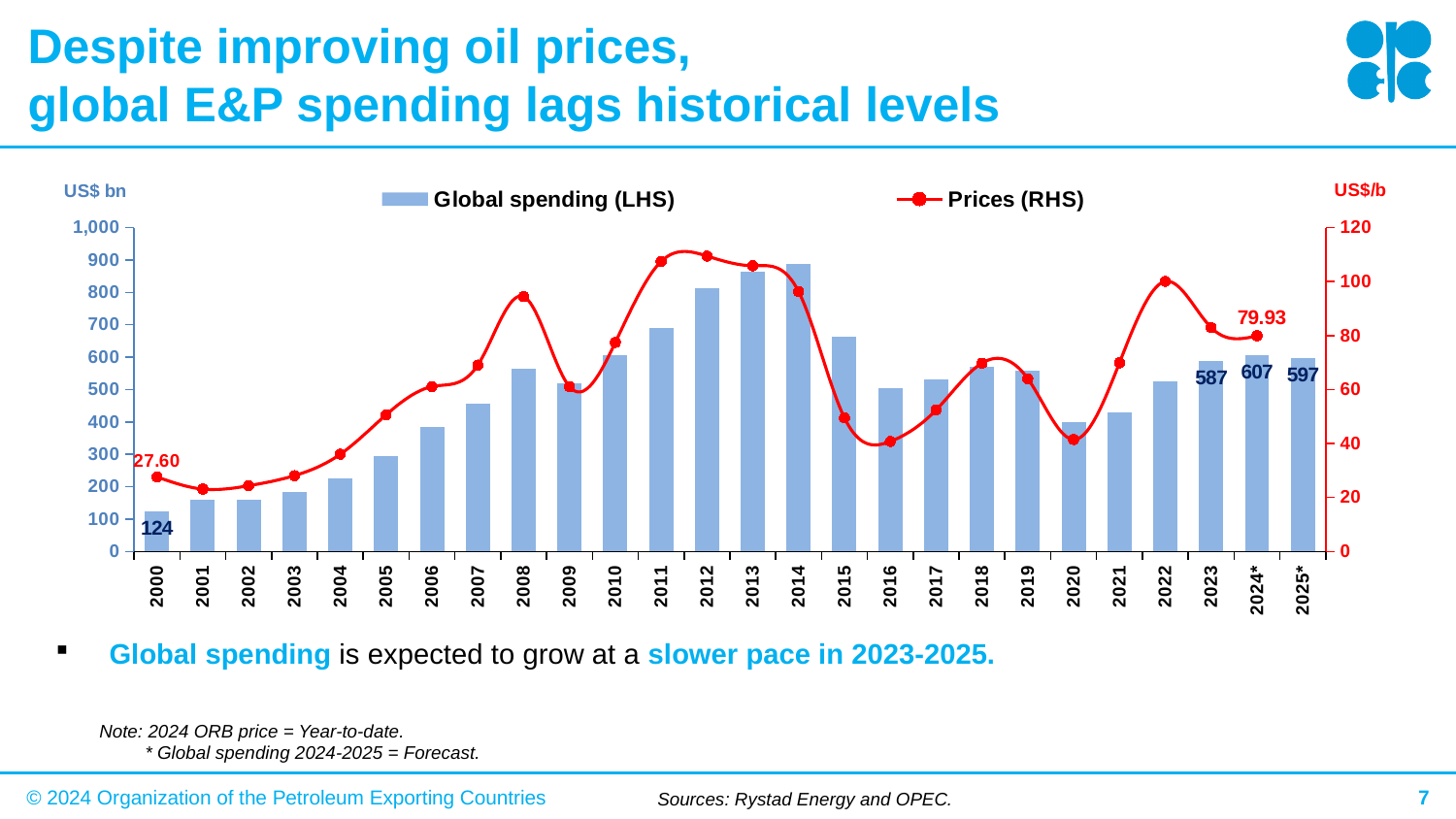
Is the Global spending value for 2016 greater or less than 600? less By how much does Global spending in 2024* exceed Global spending in 2023? 20 What is the value of Global spending (LHS) for 2024*? 607 How many series does the legend list? 2 How many years are shown on the x axis? 26 Is the Global spending value for 2014 greater or less than 800? greater Which year has the lowest Global spending? 2000 What is the Prices (RHS) value shown for 2000? 27.60 What is the value of Global spending (LHS) for 2000? 124 Which year has the larger Global spending value, 2023 or 2025*? 2025* What is the Prices (RHS) value shown for 2024*? 79.93 What is the difference between Global spending in 2024* and 2025*? 10